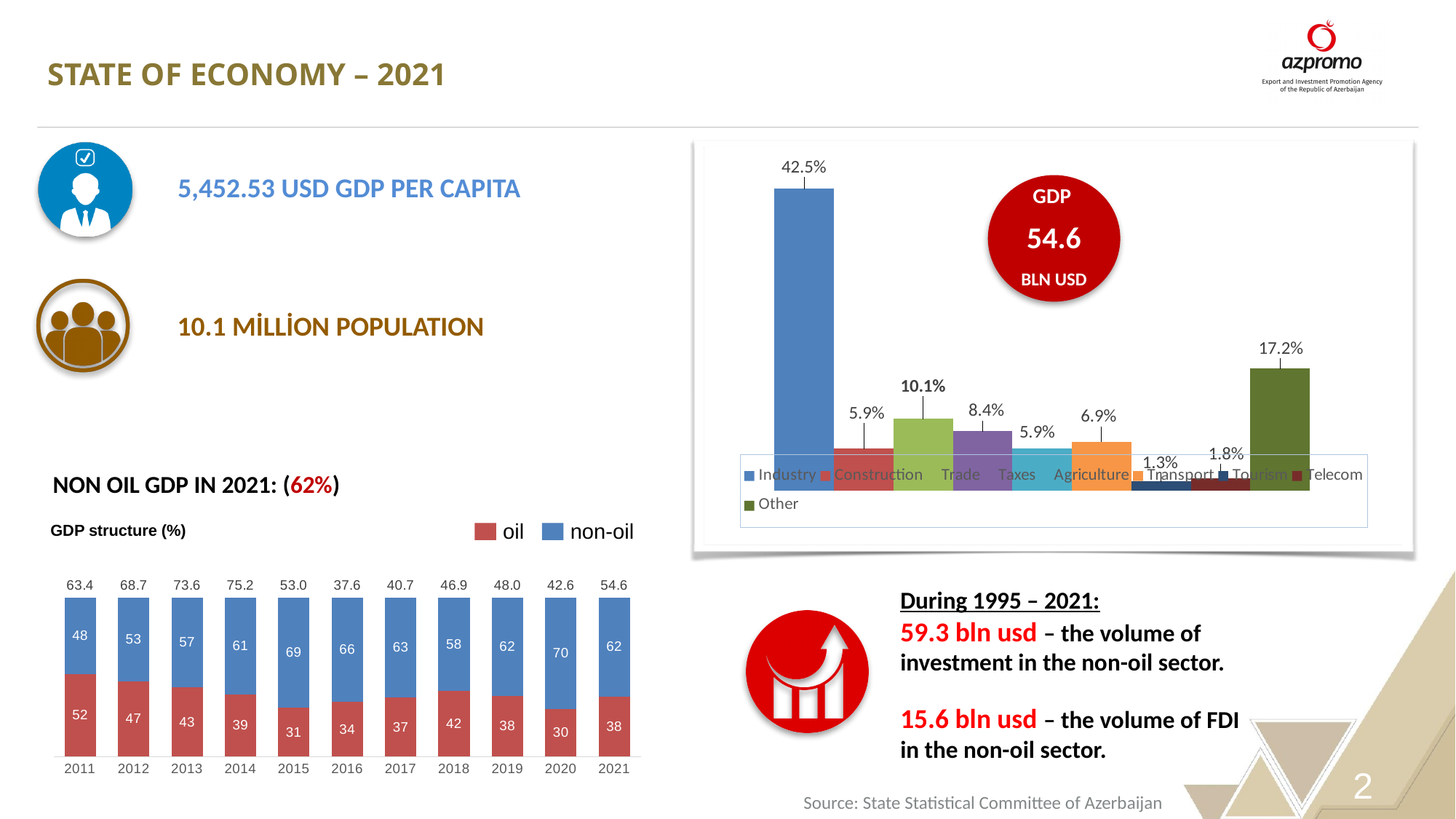
In the GDP structure (%) chart, how many series does the legend list? 2 In the GDP sector share chart on the right, which category has the lowest value? Tourism In the GDP sector share chart on the right, what is the value for Industry? 42.5% In the GDP sector share chart on the right, is the value for Other larger than the value for Trade? Yes In the GDP structure (%) chart, what is the difference between the non-oil and oil values in 2021? 24 In the GDP structure (%) chart, what is the oil value for 2015? 31 In the GDP structure (%) chart, what total value is printed above the 2014 bar? 75.2 In the GDP structure (%) chart, what is the non-oil value for 2020? 70 What kind of chart is the GDP sector share chart on the right? Bar chart In the GDP structure (%) chart, how many years are shown on the x axis? 11 In the GDP structure (%) chart, which year has the lowest oil share? 2020 In the GDP structure (%) chart, which year has the highest oil share? 2011